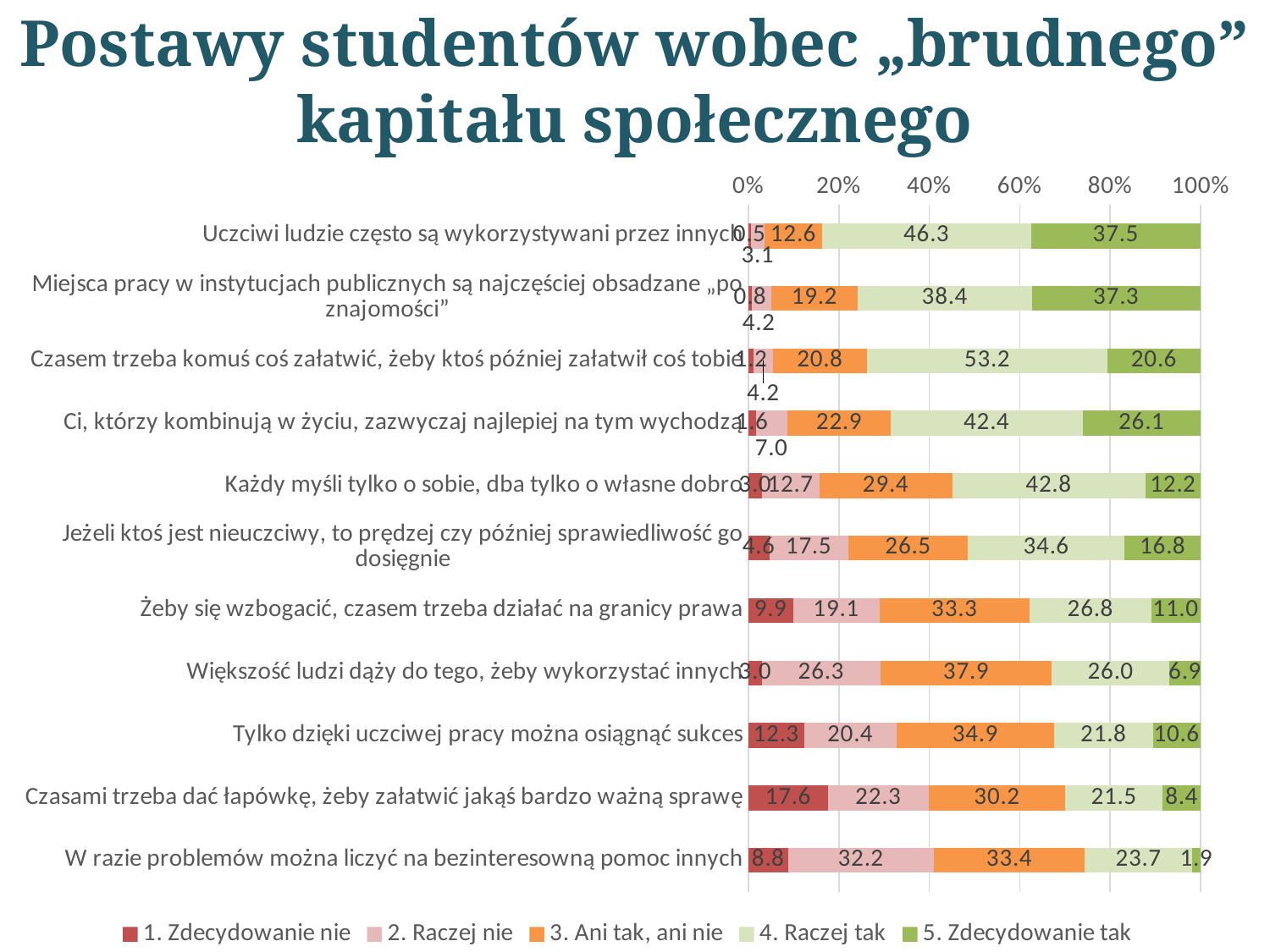
What is the value of "5. Zdecydowanie tak" for "Uczciwi ludzie często są wykorzystywani przez innych"? 37.5 How many series does the legend list? 5 What is the value of "1. Zdecydowanie nie" for "Czasami trzeba dać łapówkę, żeby załatwić jakąś bardzo ważną sprawę"? 17.6 How many statements (categories) are shown in the chart? 11 Which statement has the highest value for "1. Zdecydowanie nie"? Czasami trzeba dać łapówkę, żeby załatwić jakąś bardzo ważną sprawę What kind of chart is shown on the slide? Stacked bar chart Which statement has the lowest value for "5. Zdecydowanie tak"? W razie problemów można liczyć na bezinteresowną pomoc innych What is the difference between "4. Raczej tak" and "5. Zdecydowanie tak" for "Uczciwi ludzie często są wykorzystywani przez innych"? 8.8 Which is larger: "3. Ani tak, ani nie" for "Większość ludzi dąży do tego, żeby wykorzystać innych" or for "Żeby się wzbogacić, czasem trzeba działać na granicy prawa"? Większość ludzi dąży do tego, żeby wykorzystać innych Which statement has the highest value for "4. Raczej tak"? Czasem trzeba komuś coś załatwić, żeby ktoś później załatwił coś tobie What is the value of "4. Raczej tak" for "Czasem trzeba komuś coś załatwić, żeby ktoś później załatwił coś tobie"? 53.2 What is the value of "2. Raczej nie" for "W razie problemów można liczyć na bezinteresowną pomoc innych"? 32.2